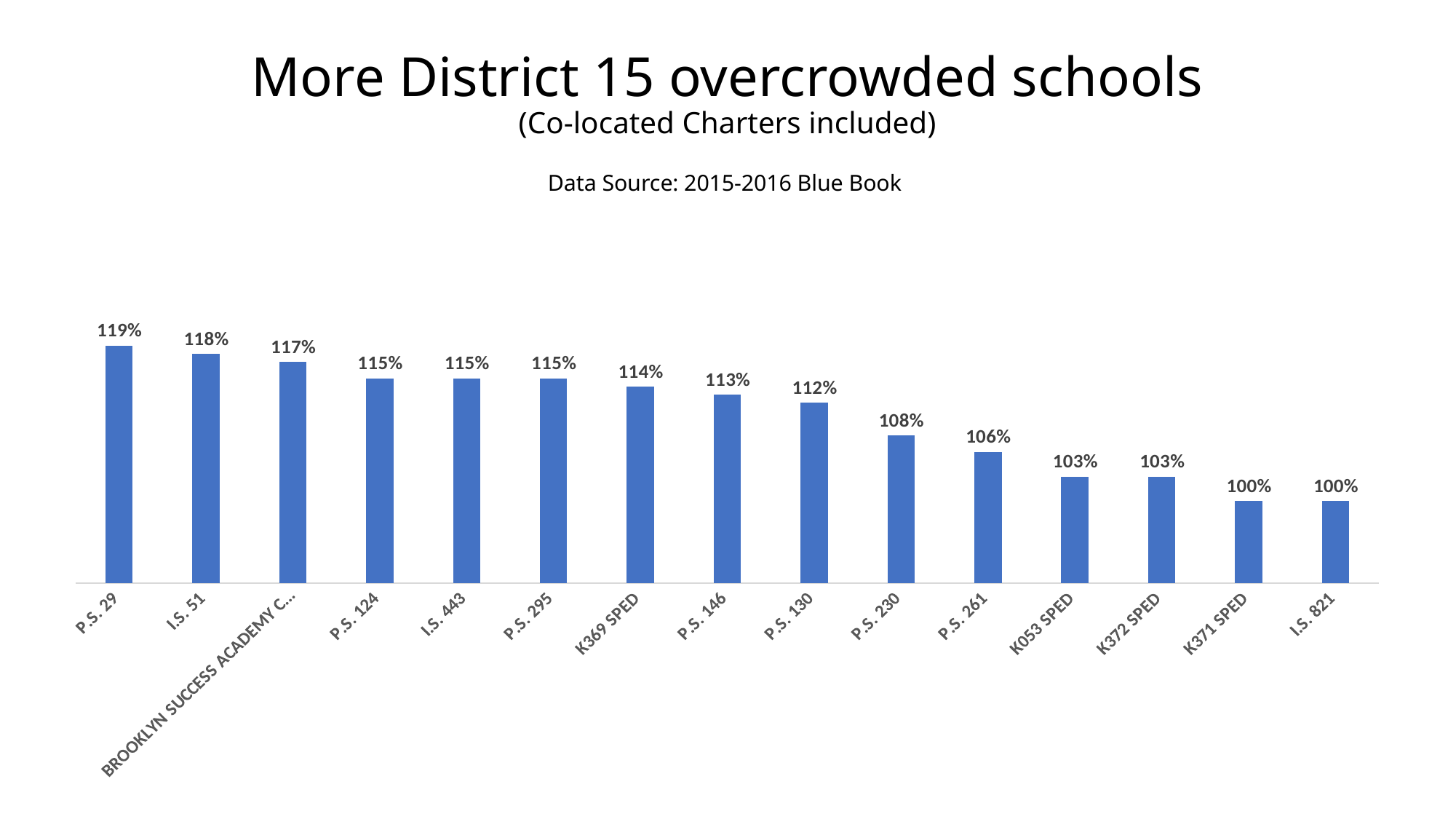
What is the value for I.S. 821? 100% Which is larger, the value for P.S. 124 or the value for K372 SPED? P.S. 124 What is the value for P.S. 230? 108% What kind of chart is shown on the slide? Bar chart Which school has the highest value? P.S. 29 What is the difference between the values for I.S. 51 and K053 SPED? 15% What is the value for P.S. 29? 119% Do the values rise or fall from left to right along the x axis? Fall Which is larger, the value for P.S. 146 or the value for P.S. 130? P.S. 146 How many schools are shown in the chart? 15 What is the value for K369 SPED? 114% What is the difference between the values for P.S. 29 and P.S. 261? 13%